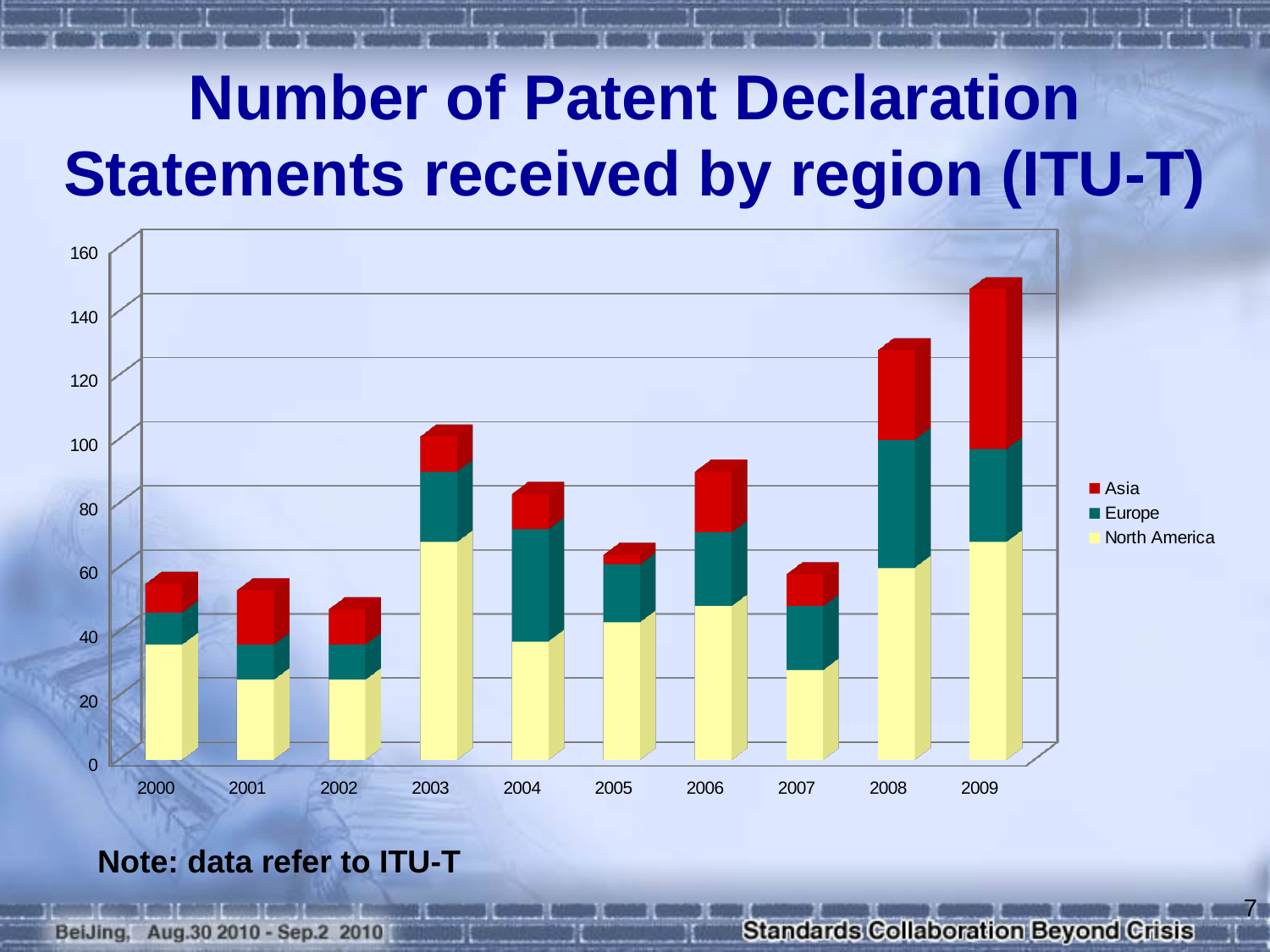
Is the total for 2006 greater or less than 80? greater Which year has the larger total, 2003 or 2004? 2003 How many years are shown along the x axis of the chart? 10 Which region is shown in red in the chart's legend? Asia Is the total for 2008 greater or less than 120? greater How many series does the chart's legend list? 3 Do the totals rise or fall from 2007 to 2009? rise Which year has the highest total number of patent declaration statements? 2009 What kind of chart is shown on the slide? Stacked bar chart Which year has the larger total, 2006 or 2007? 2006 Is the total for 2009 greater or less than 140? greater